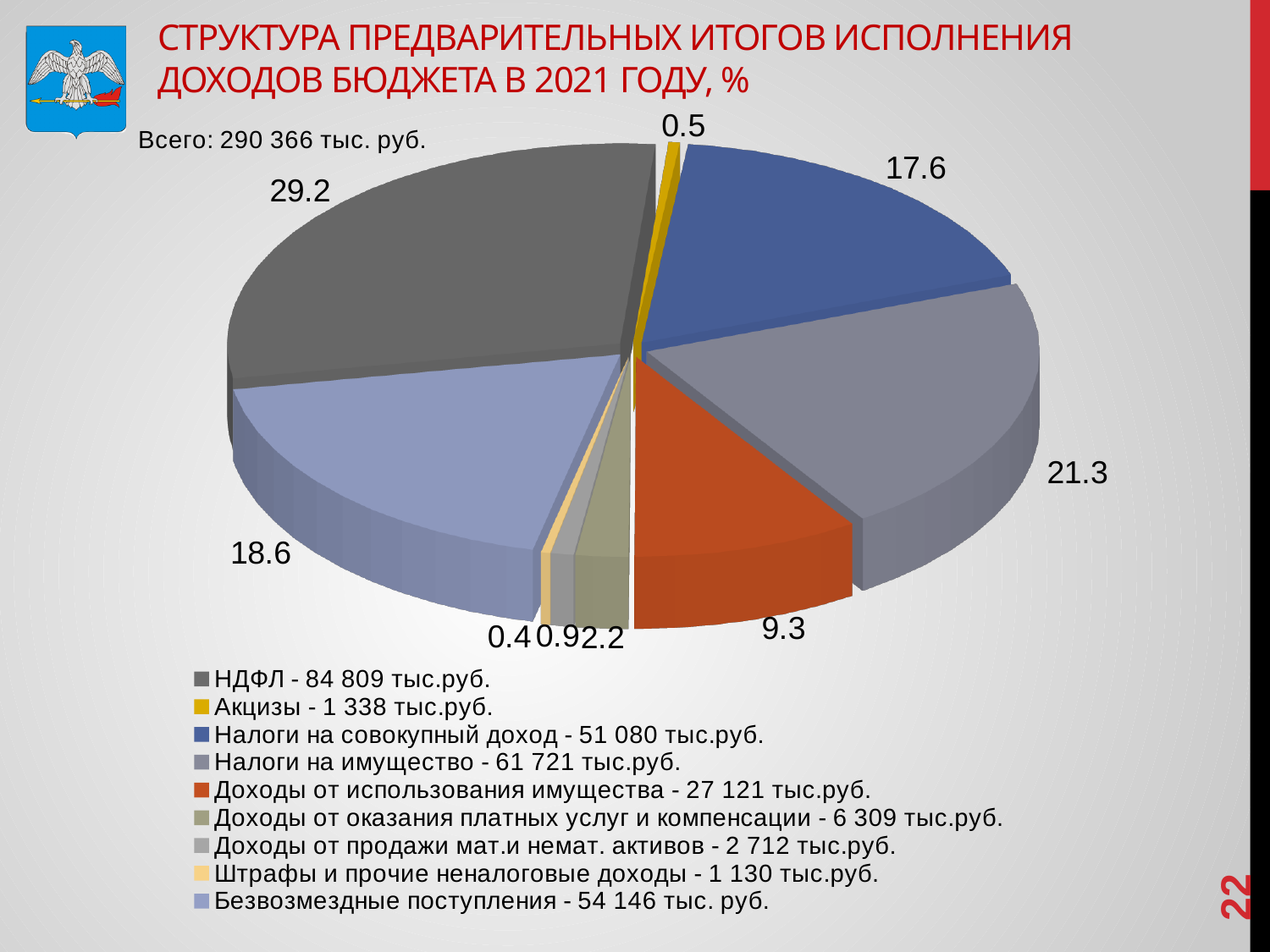
How many categories does the legend list? 9 What share of the pie does Акцизы account for? 0.5 What total amount is stated above the chart? 290 366 тыс. руб. What share of the pie does Доходы от использования имущества account for? 9.3 What share of the pie does Безвозмездные поступления account for? 18.6 Which category has the largest share of the pie? НДФЛ What type of chart is shown on the slide? pie chart Which has the larger share: Налоги на совокупный доход or Безвозмездные поступления? Безвозмездные поступления Which category has the smallest share of the pie? Штрафы и прочие неналоговые доходы What is the difference in percentage points between the shares of Налоги на имущество and Налоги на совокупный доход? 3.7